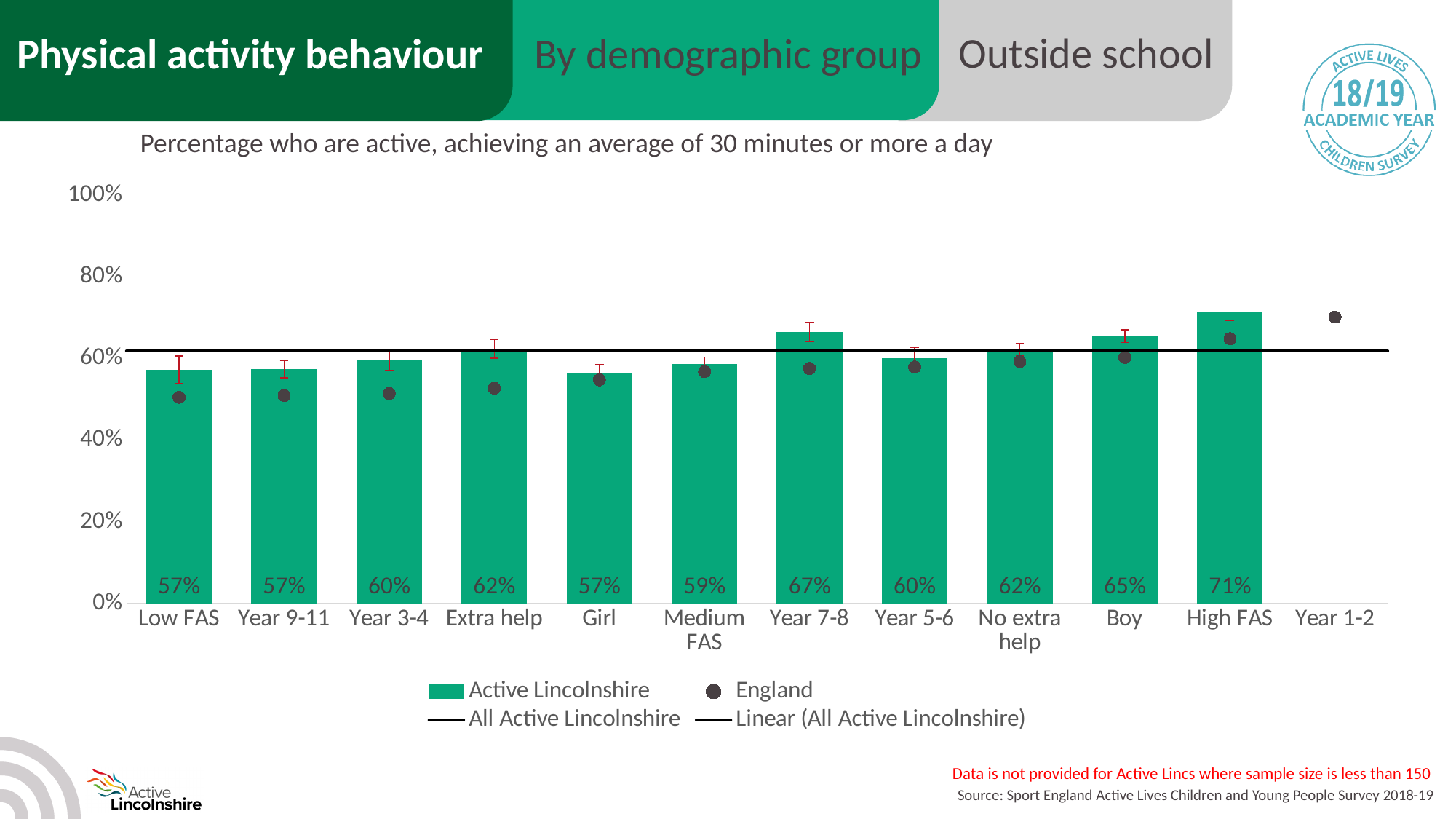
What is the Active Lincolnshire value for Medium FAS? 59% What is the Active Lincolnshire value for High FAS? 71% What is the difference between the Active Lincolnshire values for Boy and Girl? 8 percentage points Which category has the highest Active Lincolnshire bar? High FAS What type of chart is shown on the slide? Bar chart How many categories are shown on the x axis? 12 What is the difference between the Active Lincolnshire values for High FAS and Low FAS? 14 percentage points Is the England value for Year 1-2 greater or less than 60%? greater How many entries does the legend list? 4 What is the Active Lincolnshire value for Year 7-8? 67% Which has a larger Active Lincolnshire value, Year 7-8 or Year 5-6? Year 7-8 Is the England value for Low FAS greater or less than 60%? less